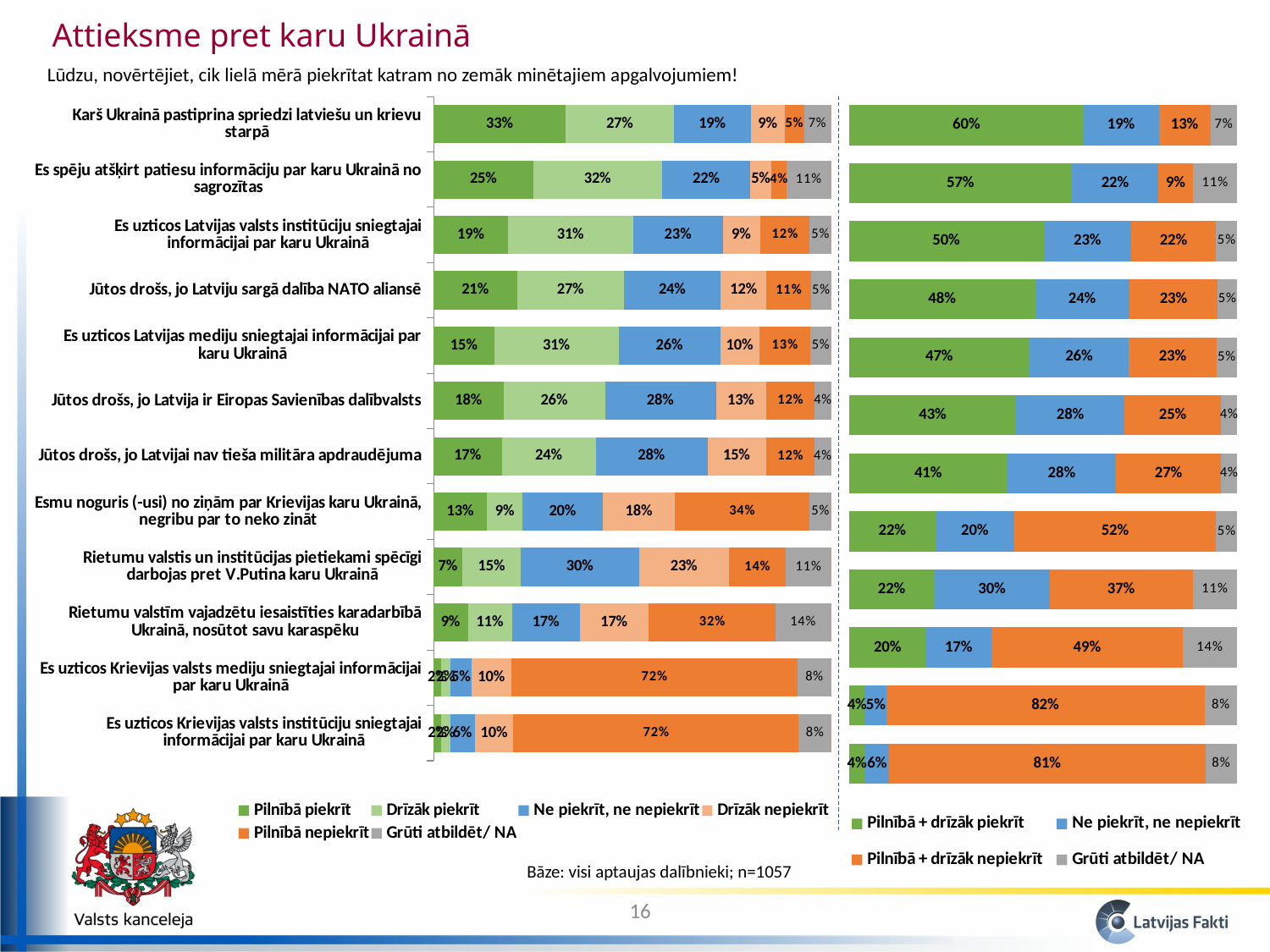
In the right-hand chart, what is the difference between the 'Pilnībā + drīzāk piekrīt' values for 'Jūtos drošs, jo Latviju sargā dalība NATO aliansē' and 'Jūtos drošs, jo Latvijai nav tieša militāra apdraudējuma'? 7% In the right-hand chart, which statement has the highest 'Pilnībā + drīzāk piekrīt' value? Karš Ukrainā pastiprina spriedzi latviešu un krievu starpā What type of chart is the right-hand chart? Stacked bar chart In the left-hand chart, which is larger for 'Rietumu valstīm vajadzētu iesaistīties karadarbībā Ukrainā, nosūtot savu karaspēku': 'Pilnībā nepiekrīt' or 'Drīzāk nepiekrīt'? Pilnībā nepiekrīt In the right-hand chart, what is the 'Pilnībā + drīzāk nepiekrīt' value for 'Esmu noguris (-usi) no ziņām par Krievijas karu Ukrainā, negribu par to neko zināt'? 52% In the left-hand chart, what is the 'Pilnībā nepiekrīt' value for 'Es uzticos Krievijas valsts mediju sniegtajai informācijai par karu Ukrainā'? 72% In the left-hand chart, what is the 'Drīzāk piekrīt' value for 'Es spēju atšķirt patiesu informāciju par karu Ukrainā no sagrozītas'? 32% How many series does the legend of the right-hand chart list? 4 In the right-hand chart, which statement has the highest 'Pilnībā + drīzāk nepiekrīt' value? Es uzticos Krievijas valsts mediju sniegtajai informācijai par karu Ukrainā How many series does the legend of the left-hand chart list? 6 In the right-hand chart, what is the 'Pilnībā + drīzāk piekrīt' value for 'Karš Ukrainā pastiprina spriedzi latviešu un krievu starpā'? 60% How many statements (categories) are shown in the left-hand chart? 12